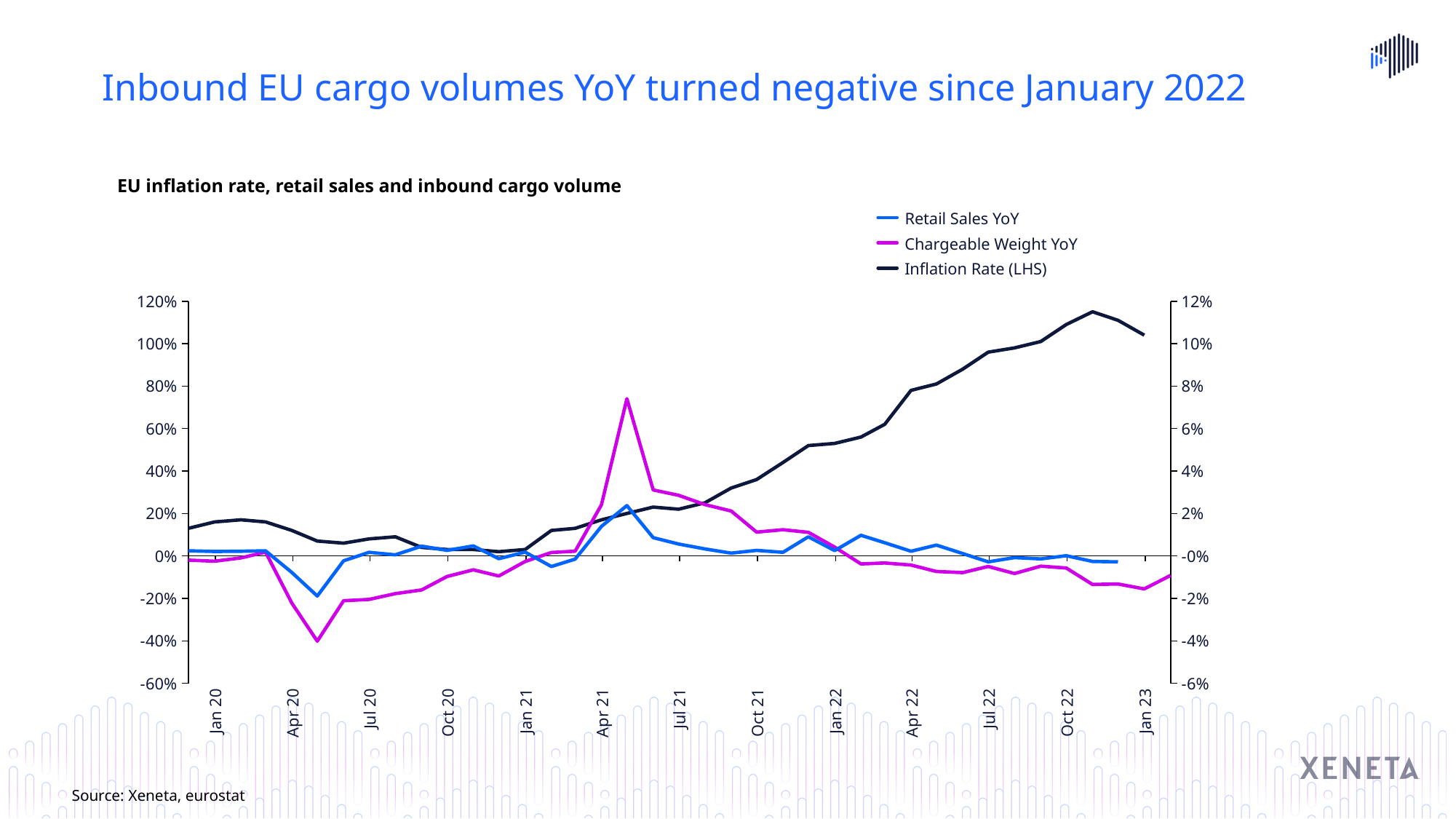
How many series does the legend list? 3 Which series reaches the lowest value on the left-hand axis? Chargeable Weight YoY What kind of chart is shown on the slide? Line chart Which colour is used for the Chargeable Weight YoY line? Magenta (pink) Is the peak value of Chargeable Weight YoY around Apr 21 greater or less than 60%? greater What is the title of the chart? EU inflation rate, retail sales and inbound cargo volume Which series reaches the highest value on the left-hand axis? Chargeable Weight YoY Is the Inflation Rate at Oct 22 greater or less than 10% on the right-hand axis? greater Does the Inflation Rate line rise or fall between Jan 21 and Oct 22? Rise Is the lowest value of Chargeable Weight YoY in 2020 greater or less than -20%? less How many date labels are shown on the x axis? 13